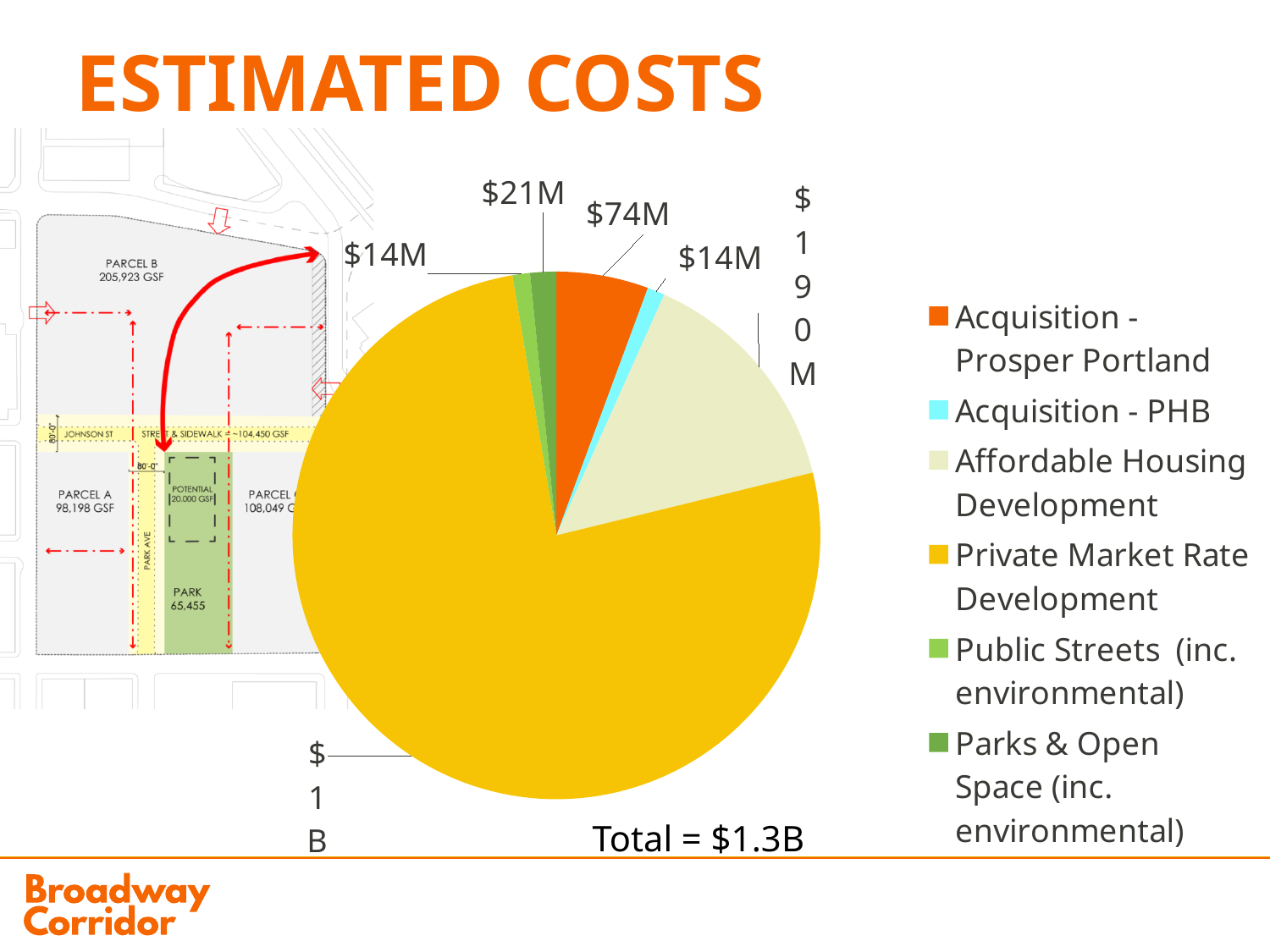
What is the difference between the Acquisition - Prosper Portland cost and the Parks & Open Space cost? $53M What is the difference between the Affordable Housing Development cost and the Acquisition - Prosper Portland cost? $116M Which category has the largest slice of the pie? Private Market Rate Development What is the estimated cost for Acquisition - Prosper Portland? $74M What is the estimated cost for Acquisition - PHB? $14M Which is larger, the cost for Parks & Open Space or the cost for Public Streets? Parks & Open Space How many slices does the pie chart have? 6 What total is stated below the pie chart? $1.3B What is the estimated cost for Affordable Housing Development? $190M What is the estimated cost for Private Market Rate Development? $1B What kind of chart is shown on the slide? Pie chart What is the estimated cost for Parks & Open Space (inc. environmental)? $21M